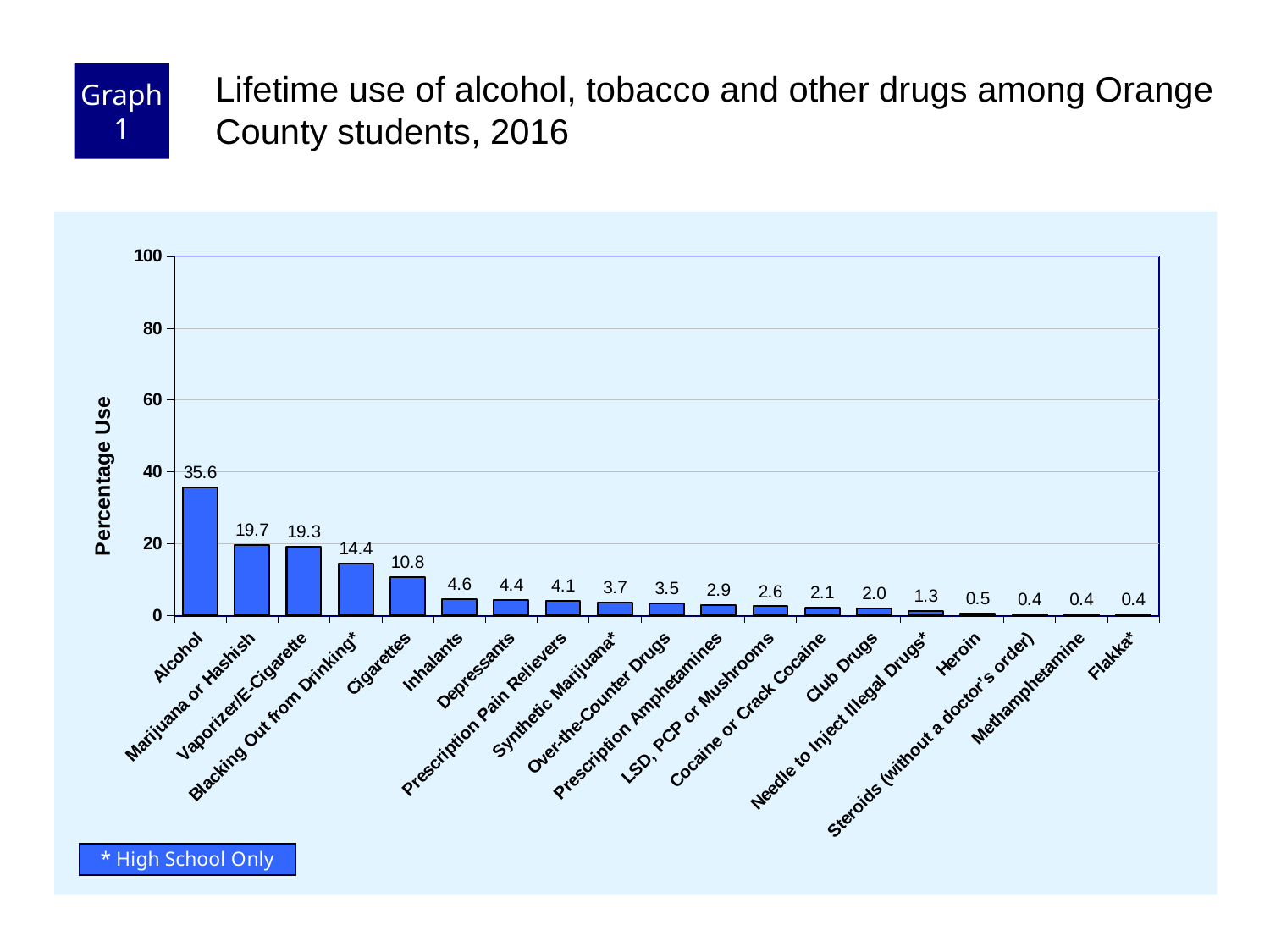
What is the difference in percentage use between Cigarettes and Inhalants? 6.2 Is the value for Alcohol greater or less than 40? less What is the percentage use for Alcohol? 35.6 What is the percentage use for Blacking Out from Drinking? 14.4 What is the difference in percentage use between Alcohol and Marijuana or Hashish? 15.9 Which category has the highest percentage use? Alcohol How many categories are shown on the x axis? 19 What is the percentage use for Heroin? 0.5 What kind of chart is shown on the slide? bar chart Which has a higher percentage use, Vaporizer/E-Cigarette or Cigarettes? Vaporizer/E-Cigarette What is the percentage use for Cigarettes? 10.8 What is the label of the y axis? Percentage Use